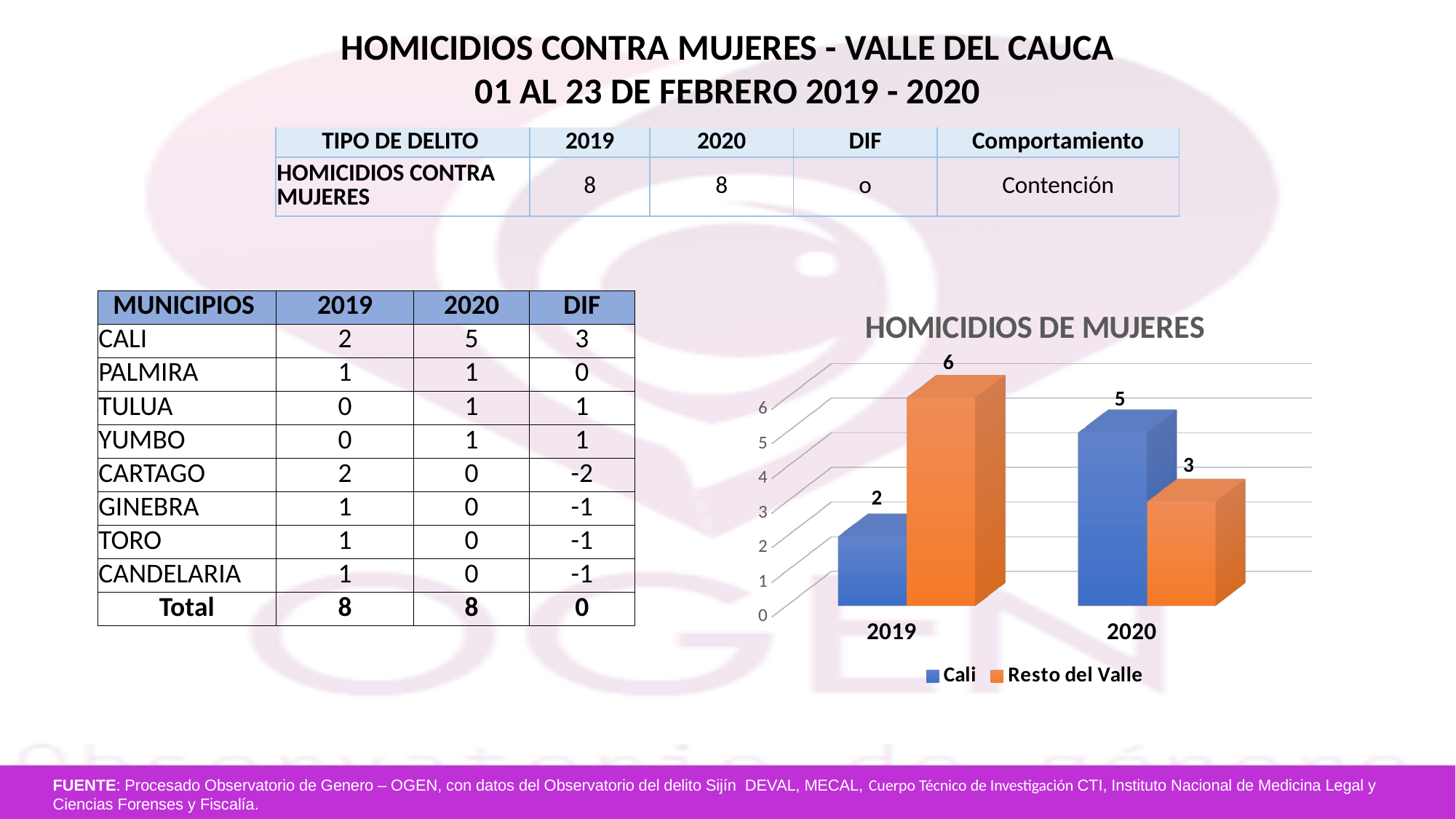
How many categories are shown on the x axis of the HOMICIDIOS DE MUJERES chart? 2 What is the value for Resto del Valle in 2019 in the HOMICIDIOS DE MUJERES chart? 6 In the HOMICIDIOS DE MUJERES chart, which series has the lowest value in 2020? Resto del Valle What is the value for Cali in 2019 in the HOMICIDIOS DE MUJERES chart? 2 In the HOMICIDIOS DE MUJERES chart, which series has the highest value in 2019? Resto del Valle What is the value for Resto del Valle in 2020 in the HOMICIDIOS DE MUJERES chart? 3 In the HOMICIDIOS DE MUJERES chart, is the value for Cali larger in 2019 or in 2020? 2020 What is the value for Cali in 2020 in the HOMICIDIOS DE MUJERES chart? 5 How many series does the legend of the HOMICIDIOS DE MUJERES chart list? 2 What kind of chart is the HOMICIDIOS DE MUJERES chart? Bar chart In the HOMICIDIOS DE MUJERES chart, what is the difference between Resto del Valle and Cali in 2019? 4 In the HOMICIDIOS DE MUJERES chart, does the value for Resto del Valle rise or fall from 2019 to 2020? Fall